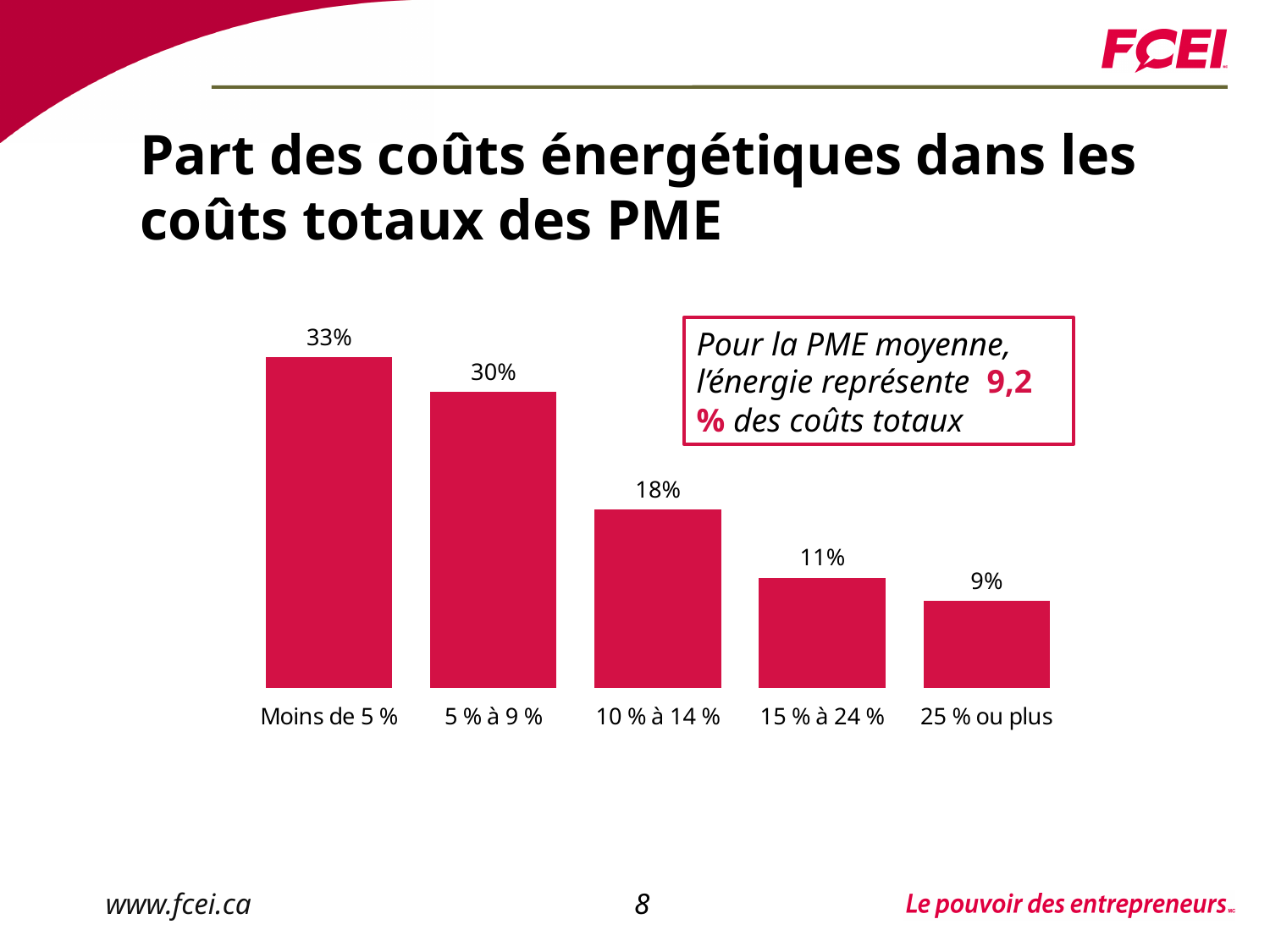
What is the difference between the values for '10 % à 14 %' and '15 % à 24 %'? 7% What is the value for the '10 % à 14 %' category? 18% Which is larger, the value for '5 % à 9 %' or the value for '10 % à 14 %'? 5 % à 9 % How many categories are shown in the chart? 5 What is the value for the '25 % ou plus' category? 9% What is the difference between the values for 'Moins de 5 %' and '5 % à 9 %'? 3% According to the text box on the slide, what share of total costs does energy represent for the average SME? 9,2 % Do the values rise or fall from left to right along the x axis? Fall Which category has the highest value? Moins de 5 % What is the value for the 'Moins de 5 %' category? 33% Which category has the lowest value? 25 % ou plus What kind of chart is shown on the slide? Bar chart